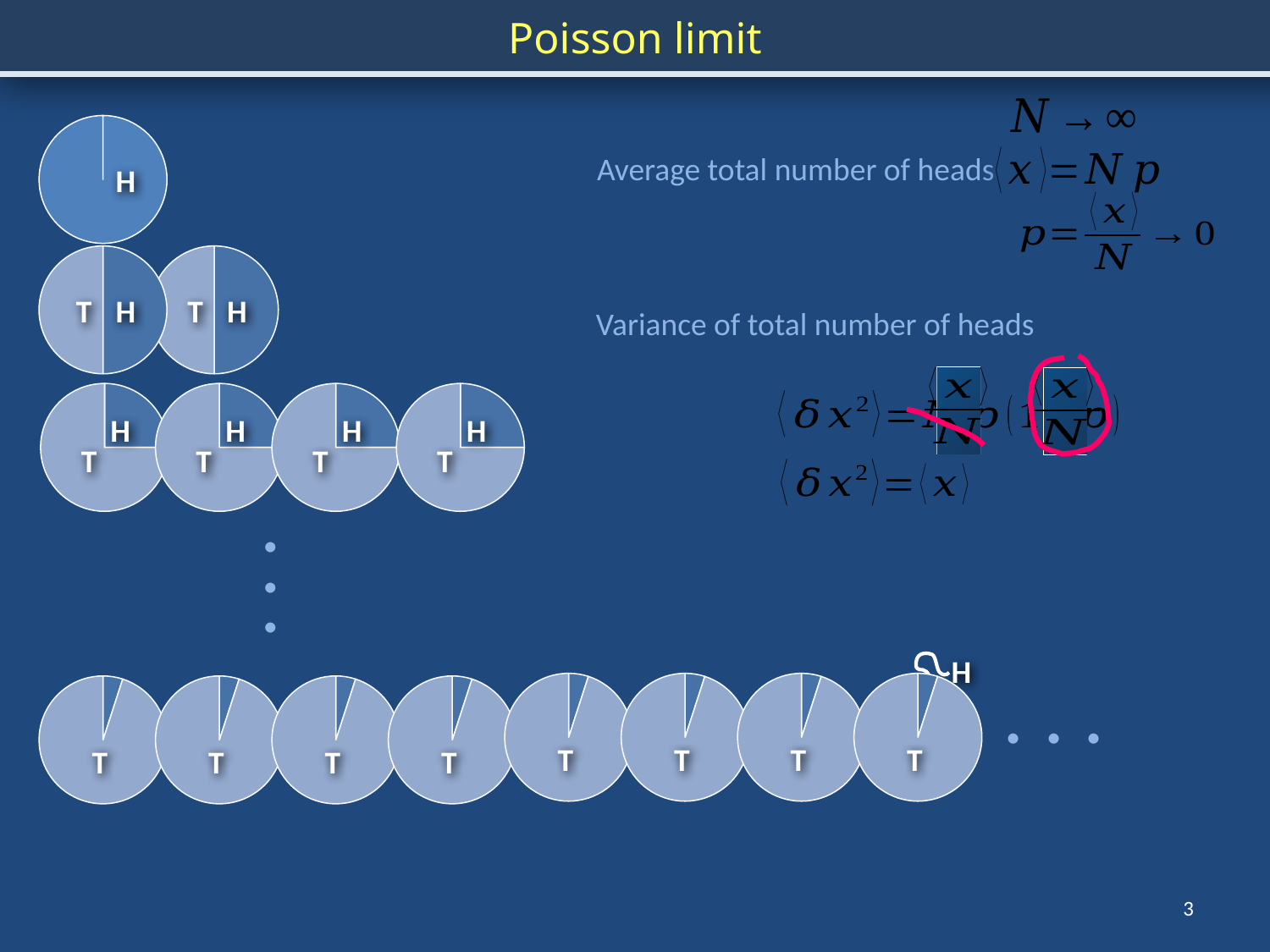
How many pie charts are shown in total on the slide? 15 In the pie charts of the bottom row, which slice is larger, T or H? T In the pie charts of the third row, which slice is larger, T or H? T How many slices does the single pie chart at the top of the slide have? 1 Going from the top row of pie charts to the bottom row, does the share of the H slice increase or decrease? decrease What two labels are used for the slices in the pie charts? H and T How many pie charts are in the bottom row of the slide? 8 What is the only label shown in the top pie chart? H What is the title of the slide containing the pie charts? Poisson limit What kind of chart is used to represent the coin flips on this slide? pie chart